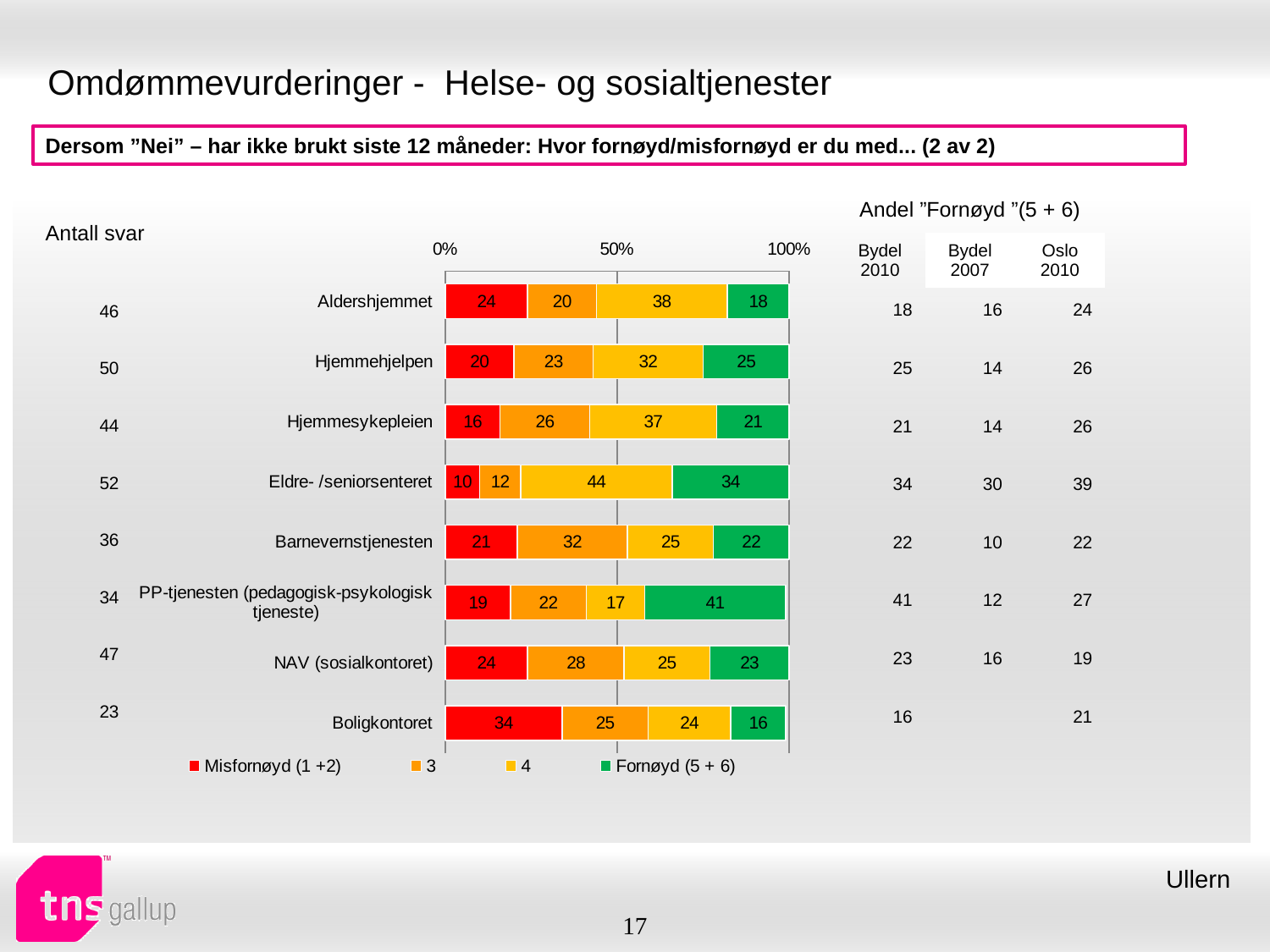
What is the value of the Fornøyd (5 + 6) segment for PP-tjenesten (pedagogisk-psykologisk tjeneste)? 41 What is the total of the stacked bar for Aldershjemmet? 100 Which has the larger Misfornøyd (1 +2) value, Aldershjemmet or Hjemmesykepleien? Aldershjemmet Which category has the lowest Misfornøyd (1 +2) value? Eldre- /seniorsenteret Which category has the highest Fornøyd (5 + 6) value? PP-tjenesten (pedagogisk-psykologisk tjeneste) What kind of chart is shown on the slide? Stacked bar chart What is the difference between the Fornøyd (5 + 6) values for Eldre- /seniorsenteret and Aldershjemmet? 16 What is the value of the Misfornøyd (1 +2) segment for Boligkontoret? 34 How many categories are shown in the bar chart? 8 What is the first entry in the chart legend? Misfornøyd (1 +2) What is the value of the '4' segment for Eldre- /seniorsenteret? 44 How many series does the legend list? 4